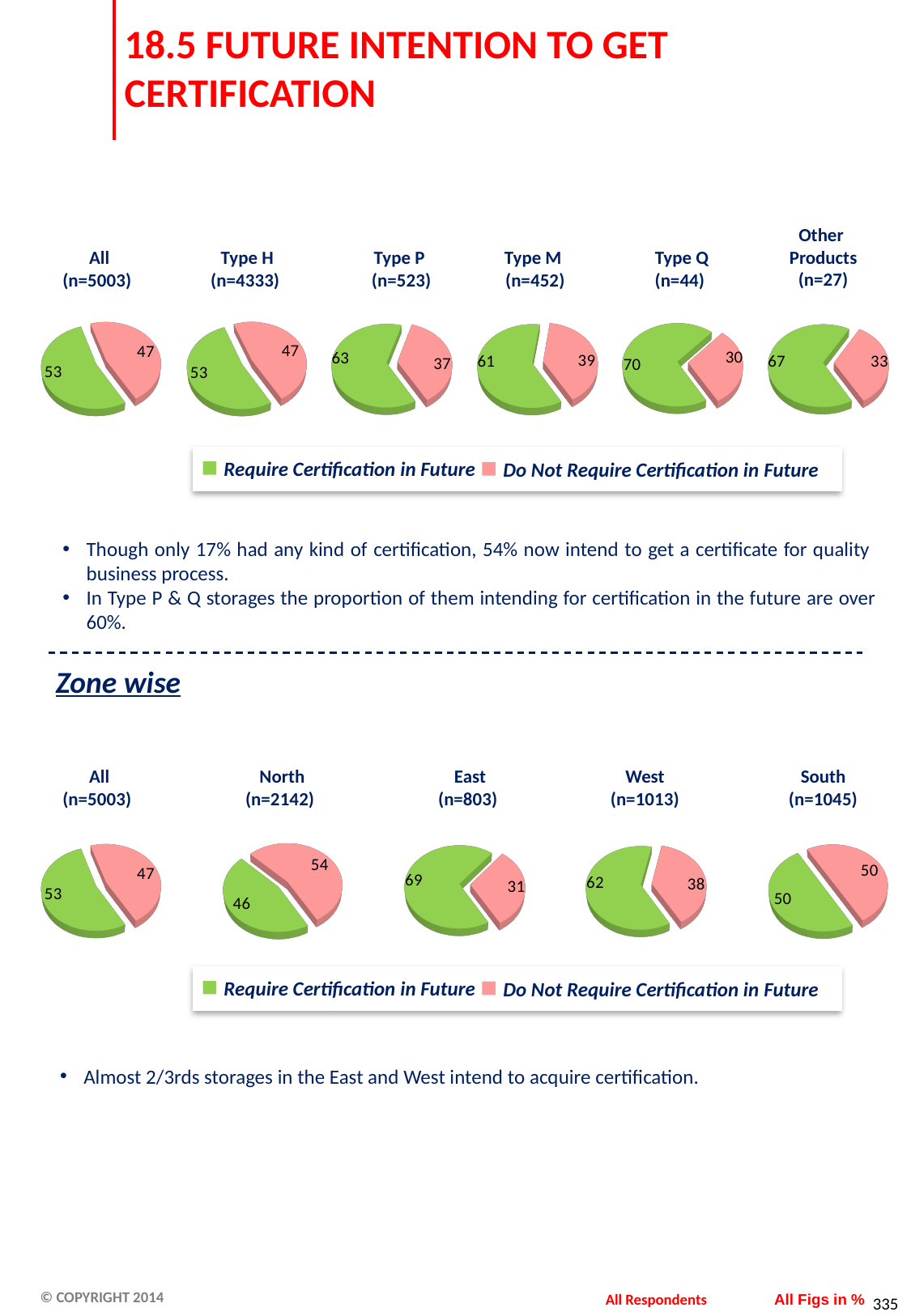
How many entries does the legend below the top row of pie charts list? 2 In the top row of pie charts, what is the value for 'Do Not Require Certification in Future' in the Type P (n=523) pie? 37 In the Zone wise row of pie charts, what is the value for 'Do Not Require Certification in Future' in the North (n=2142) pie? 54 In the top row of pie charts, which is larger: the 'Require Certification in Future' value for Type M or for Other Products? Other Products In the Zone wise row of pie charts, which pie has the lowest value for 'Require Certification in Future'? North (n=2142) How many pie charts are in the top row (by storage type)? 6 In the Zone wise row of pie charts, what is the difference between the 'Require Certification in Future' values for East and West? 7 In the top row of pie charts, which pie has the highest value for 'Require Certification in Future'? Type Q (n=44) In the top row of pie charts, what is the value for 'Require Certification in Future' in the Type Q (n=44) pie? 70 What type of chart is used to show the future intention to get certification on this slide? Pie chart How many pie charts are in the Zone wise row? 5 In the Zone wise row of pie charts, what is the value for 'Require Certification in Future' in the East (n=803) pie? 69